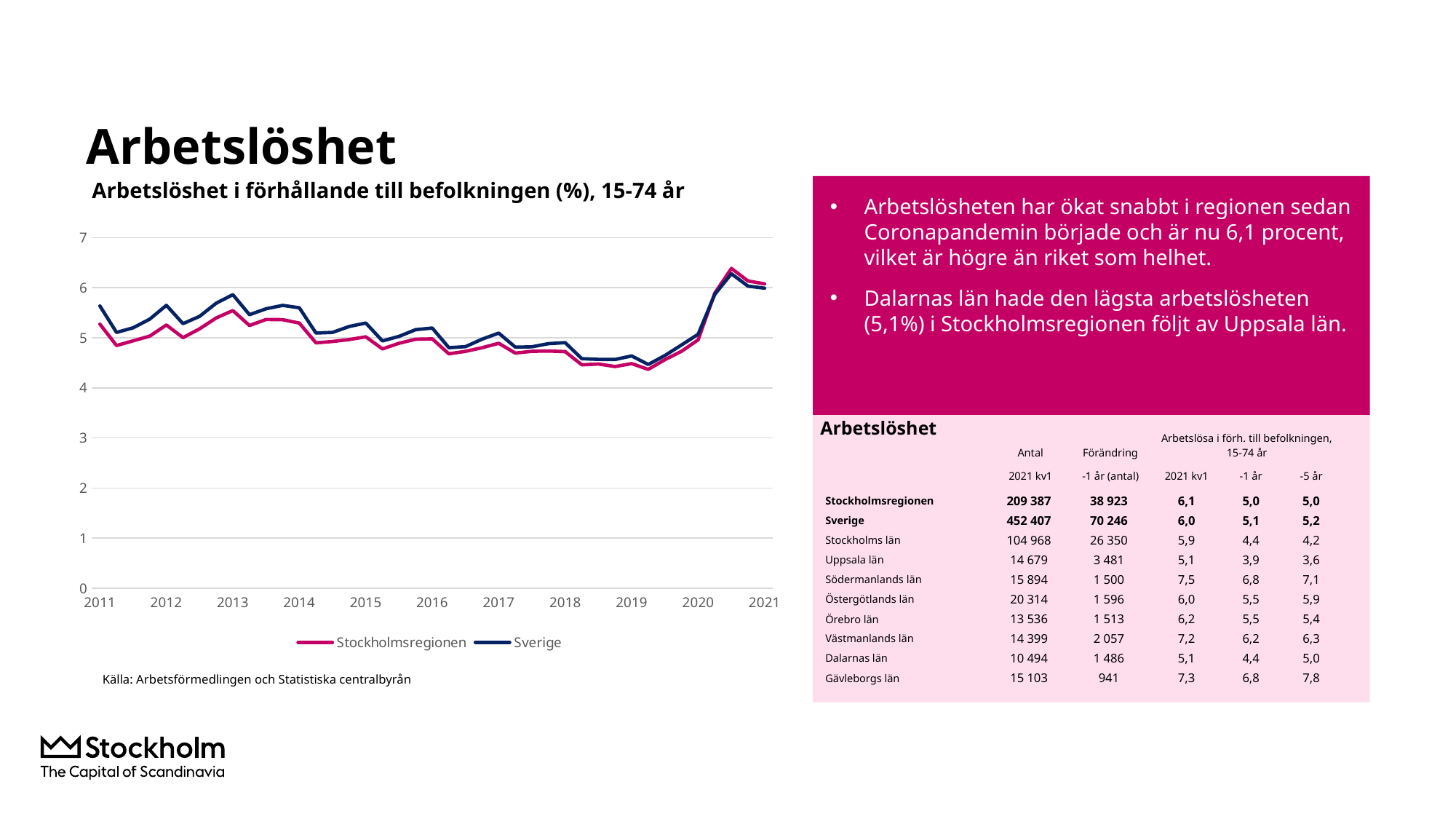
How many years are labelled on the x axis of the chart? 11 Do the values for Sverige rise or fall between 2019 and 2021? rise How many series does the chart legend list? 2 Is the value for Stockholmsregionen at the start of 2018 greater or less than 5? less Is the value for Stockholmsregionen at the start of 2019 greater or less than 5? less Do the values for Stockholmsregionen rise or fall between 2013 and 2019? fall What is the title of the chart? Arbetslöshet i förhållande till befolkningen (%), 15-74 år At the start of 2013, which series has the higher value, Stockholmsregionen or Sverige? Sverige Is the value for Sverige at the start of 2013 greater or less than 5? greater Which series is drawn in pink/magenta in the chart? Stockholmsregionen What kind of chart is shown on the slide? line chart